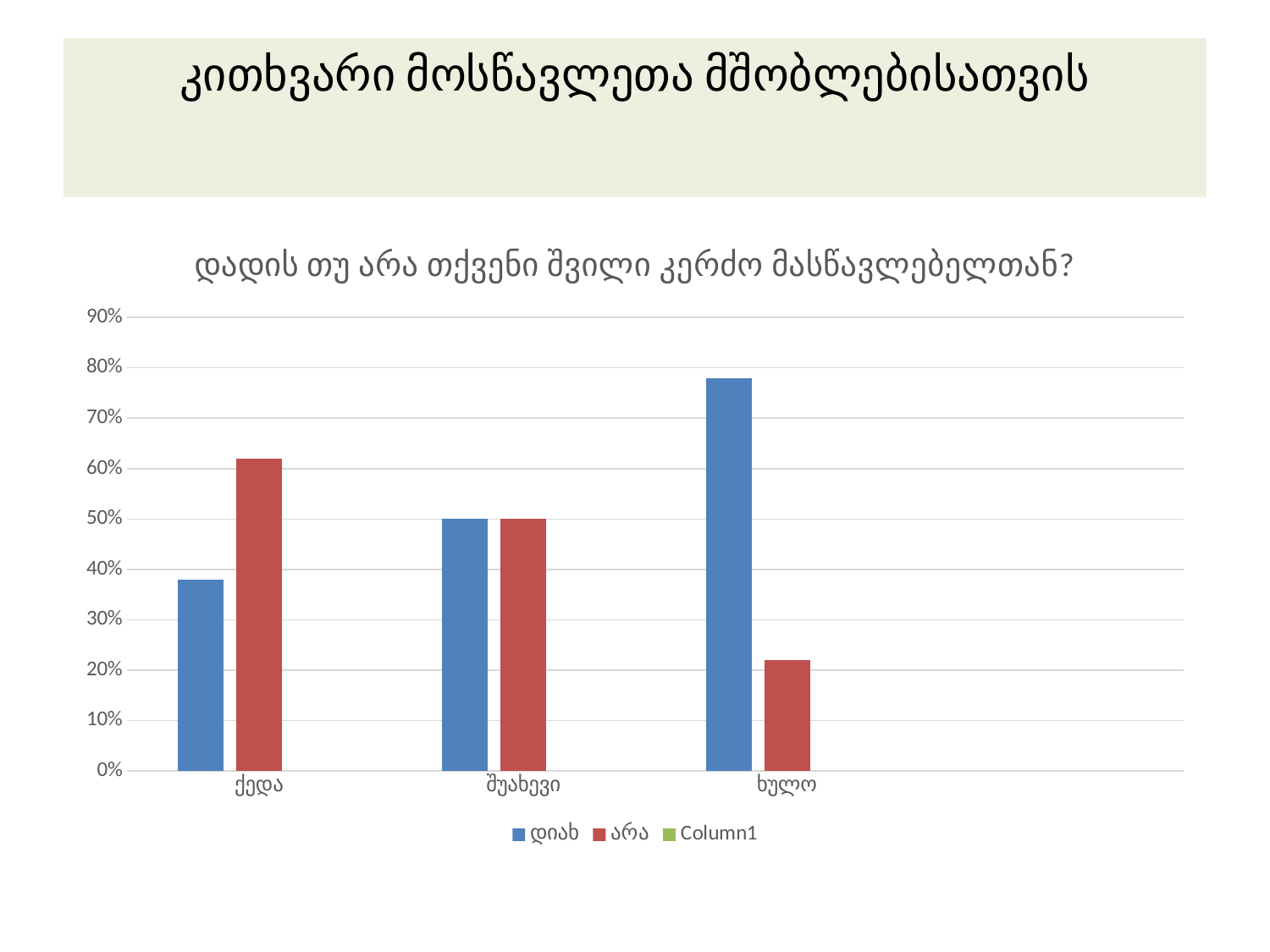
What is the value of the დიახ series for შუახევი? 50% How many series does the chart legend list? 3 What kind of chart is shown on the slide? bar chart Which category has the highest value for the დიახ series? ხულო Which category has the lowest value for the არა series? ხულო Is the value of the არა series for ხულო greater or less than 30%? less Is the value of the დიახ series for ქედა greater or less than 40%? less What is the value of the არა series for შუახევი? 50% How many categories are shown on the x axis of the chart? 3 Is the value of the არა series for ქედა greater or less than 60%? greater For ქედა, which is larger: the დიახ value or the არა value? არა